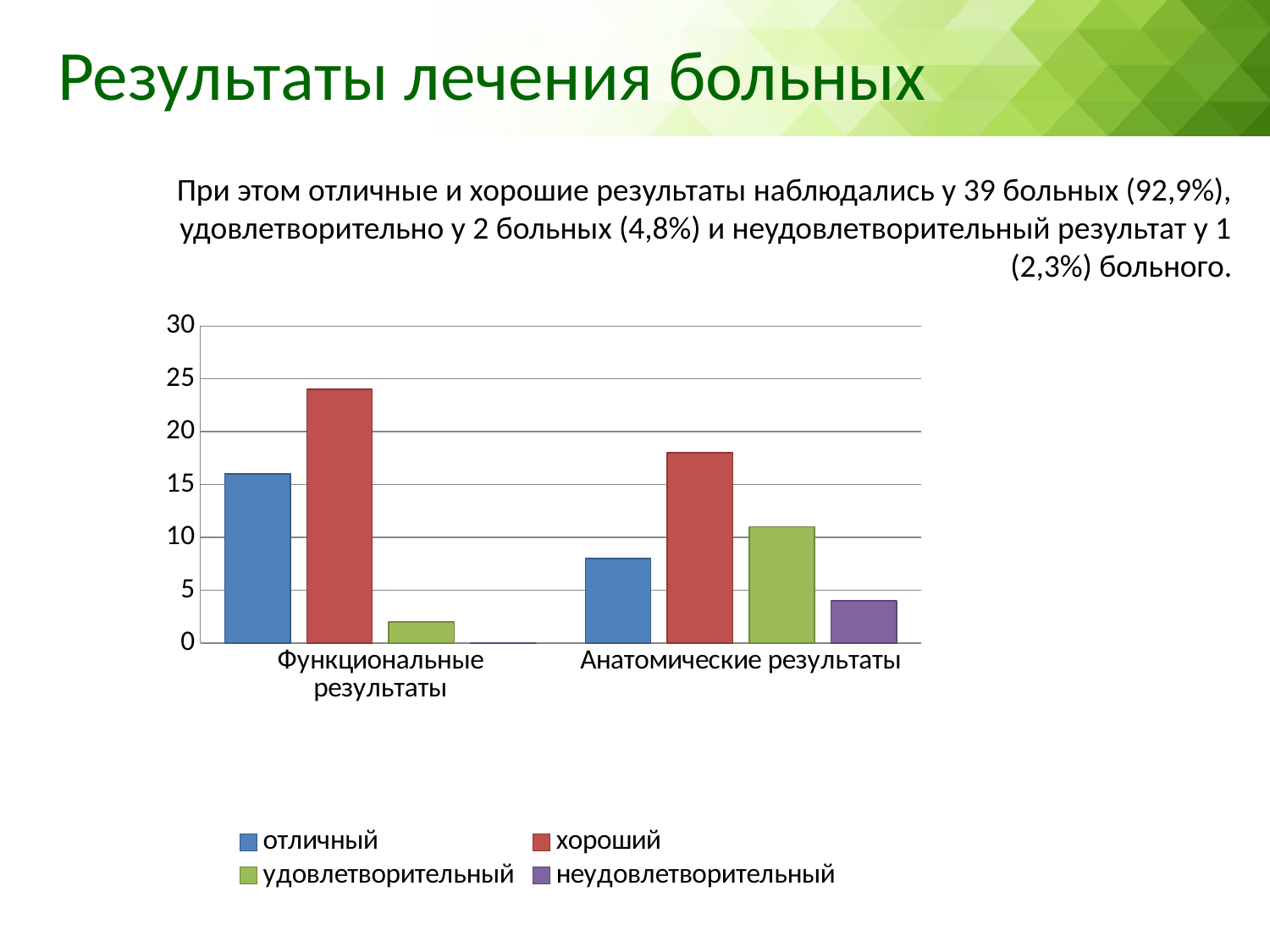
Which series has the highest value in the Функциональные результаты category? хороший Which is larger: отличный in Функциональные результаты or отличный in Анатомические результаты? Функциональные результаты Which series has the lowest value in the Анатомические результаты category? неудовлетворительный How many categories are shown on the x axis? 2 Is the value for удовлетворительный in Анатомические результаты greater or less than 10? greater Is the value for хороший in Функциональные результаты greater or less than 20? greater Is the value for неудовлетворительный in Анатомические результаты greater or less than 5? less What kind of chart is shown on the slide? bar chart Which is larger: удовлетворительный in Функциональные результаты or удовлетворительный in Анатомические результаты? Анатомические результаты How many series does the legend list? 4 What colour represents the хороший series in the chart? red